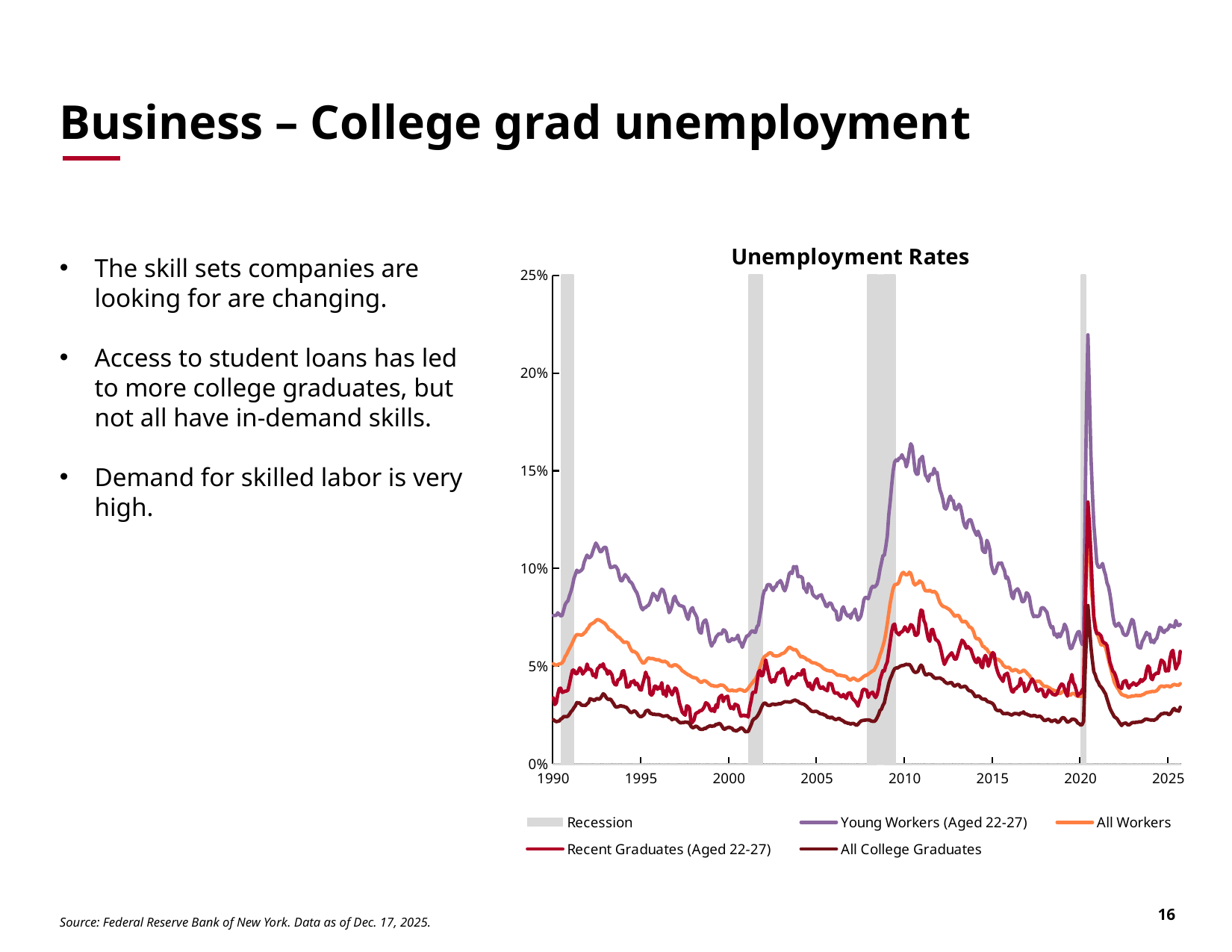
How many line series are plotted in the Unemployment Rates chart? 4 What kind of chart is shown on the slide? line chart Is the peak value for All Workers around 2010 greater or less than 5%? greater Is the peak value for Young Workers (Aged 22-27) around 2020 greater or less than 20%? greater Is the value for All College Graduates in 1990 greater or less than 5%? less Which series has the highest unemployment rate across the chart? Young Workers (Aged 22-27) What is the title of the chart? Unemployment Rates What do the grey shaded vertical bands in the chart represent? Recession Around 2010, which is larger: the unemployment rate for Young Workers (Aged 22-27) or for All Workers? Young Workers (Aged 22-27) Does the unemployment rate for Young Workers (Aged 22-27) rise or fall between 2010 and 2019? fall Which series has the lowest unemployment rate across the chart? All College Graduates